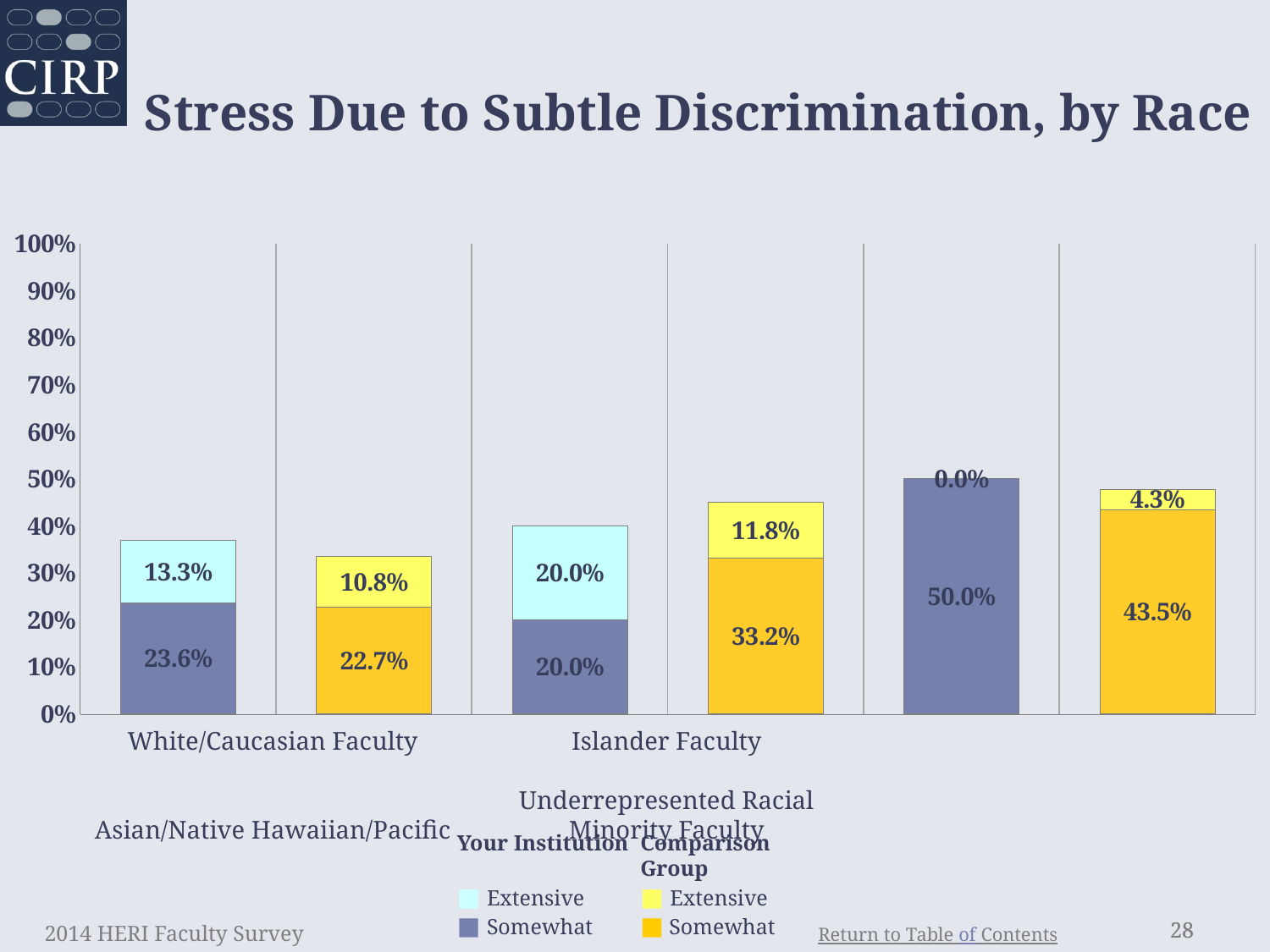
How many race categories are shown on the x axis? 3 What is the total of the Your Institution stacked bar for White/Caucasian Faculty? 36.9% How many entries does the legend list? 4 What is the 'Somewhat' value for Your Institution among White/Caucasian Faculty? 23.6% What type of chart is shown on the slide? Stacked bar chart Which race group has the highest 'Somewhat' value for Your Institution? Underrepresented Racial Minority Faculty Which is larger: the Your Institution 'Extensive' value for White/Caucasian Faculty or for Asian/Native Hawaiian/Pacific Islander Faculty? Asian/Native Hawaiian/Pacific Islander Faculty What is the 'Somewhat' value for Your Institution among Underrepresented Racial Minority Faculty? 50.0% What is the total of the Comparison Group stacked bar for Underrepresented Racial Minority Faculty? 47.8% What is the difference between the Comparison Group 'Somewhat' values for Underrepresented Racial Minority Faculty and White/Caucasian Faculty? 20.8% What is the 'Extensive' value for the Comparison Group among Asian/Native Hawaiian/Pacific Islander Faculty? 11.8% What is the 'Extensive' value for Your Institution among Underrepresented Racial Minority Faculty? 0.0%